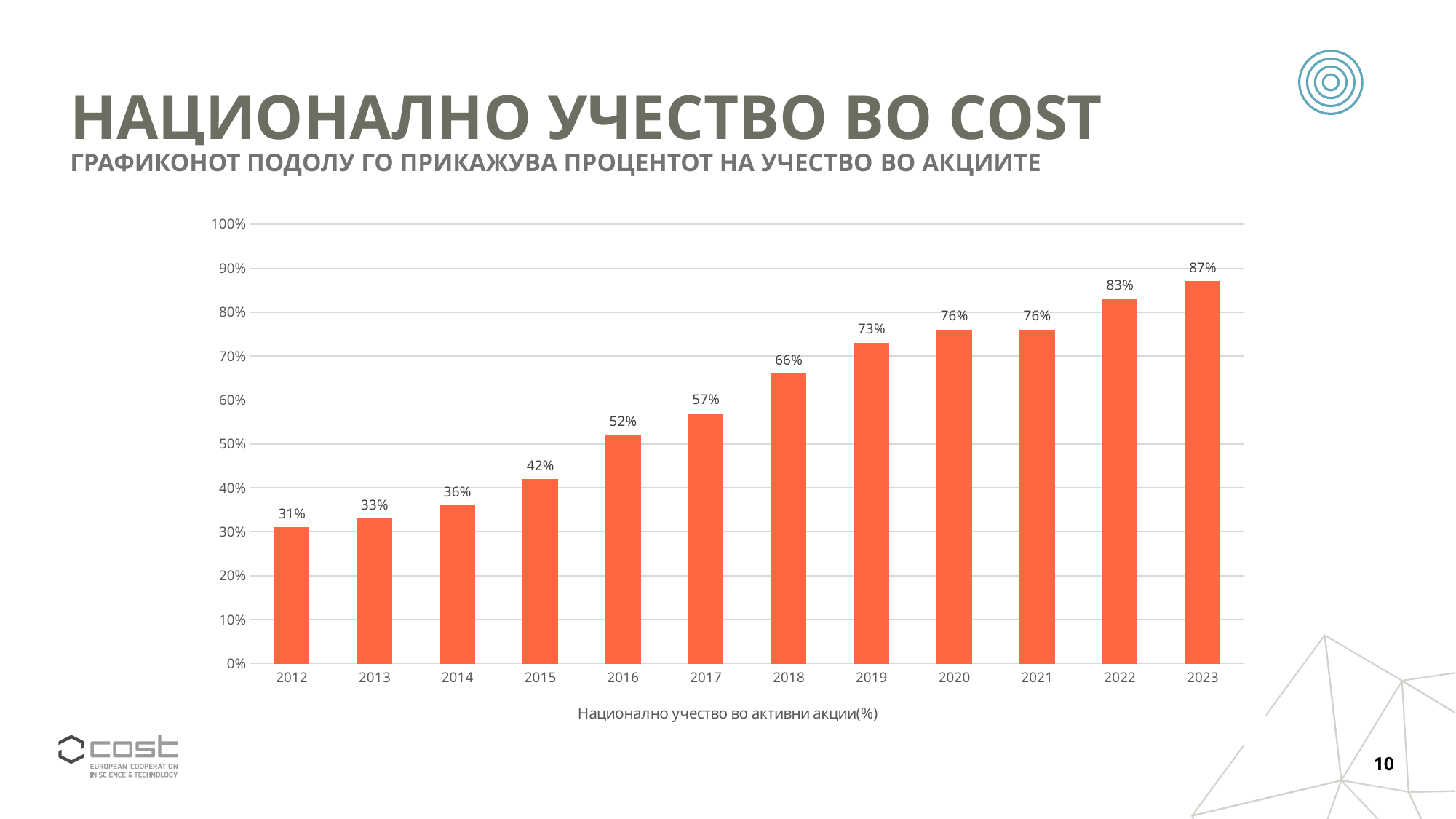
Which is larger, the value for 2019 or the value for 2015? 2019 What is the value for 2012? 31% Do the values generally rise or fall from 2012 to 2023? Rise How many years are shown on the x axis? 12 Is the value for 2020 greater or less than 70%? greater What is the difference between the values for 2023 and 2012? 56% What kind of chart is shown on the slide? Bar chart What is the difference between the values for 2017 and 2016? 5% Which year has the highest value? 2023 What is the value for 2018? 66% Which year has the lowest value? 2012 What is the value for 2022? 83%